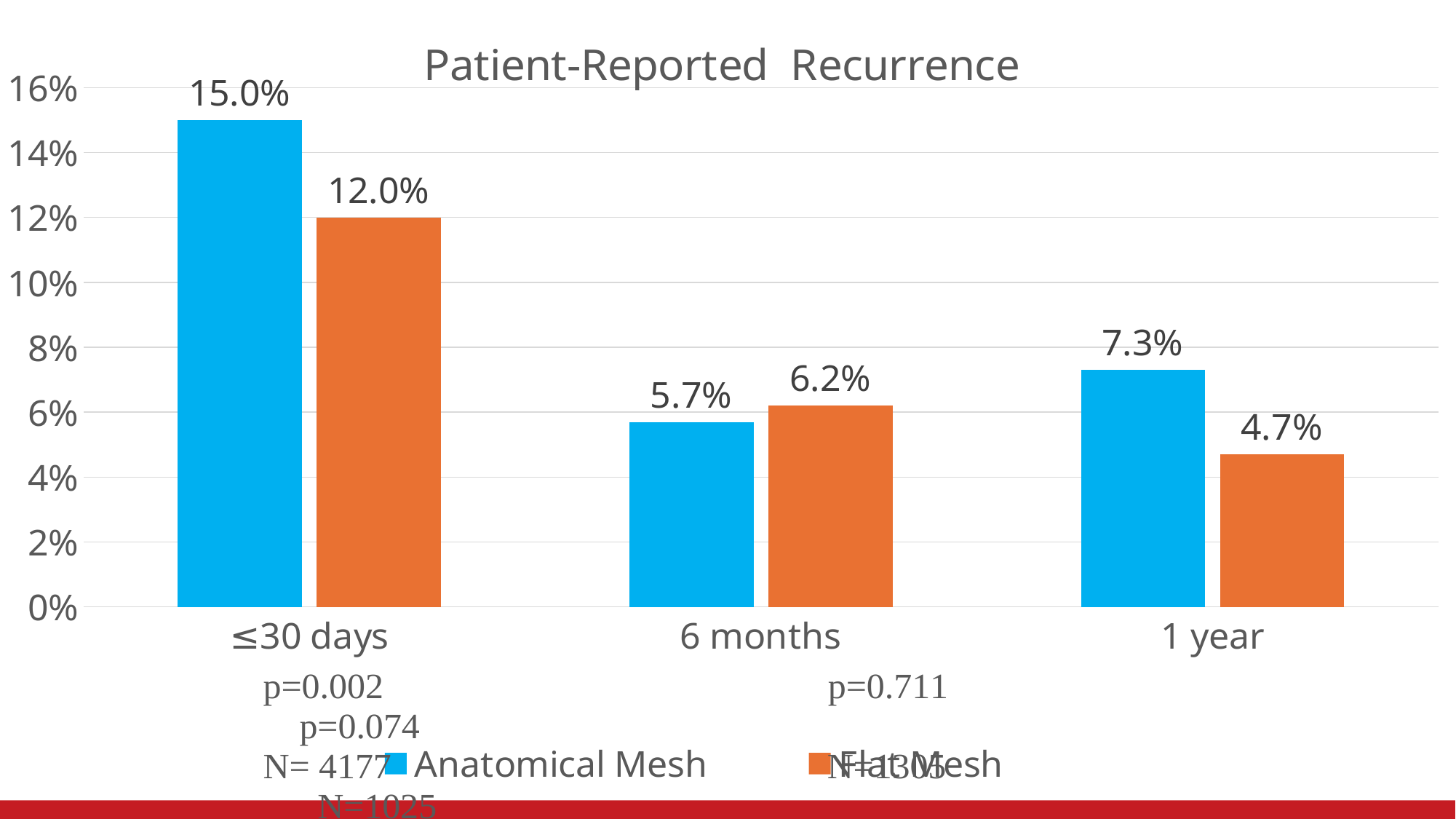
How many series does the legend list? 2 At which time point is the Flat Mesh recurrence lowest? 1 year At 6 months, which series has the higher recurrence, Anatomical Mesh or Flat Mesh? Flat Mesh What is the title of the chart? Patient-Reported Recurrence How many time-point categories are shown on the x axis? 3 What is the patient-reported recurrence for Anatomical Mesh at ≤30 days? 15.0% At which time point is the Anatomical Mesh recurrence highest? ≤30 days What is the patient-reported recurrence for Flat Mesh at 6 months? 6.2% What kind of chart is shown on the slide? Bar chart What is the patient-reported recurrence for Flat Mesh at 1 year? 4.7% What is the difference between the Anatomical Mesh and Flat Mesh recurrence at ≤30 days? 3.0% What is the difference between the Anatomical Mesh and Flat Mesh recurrence at 1 year? 2.6%